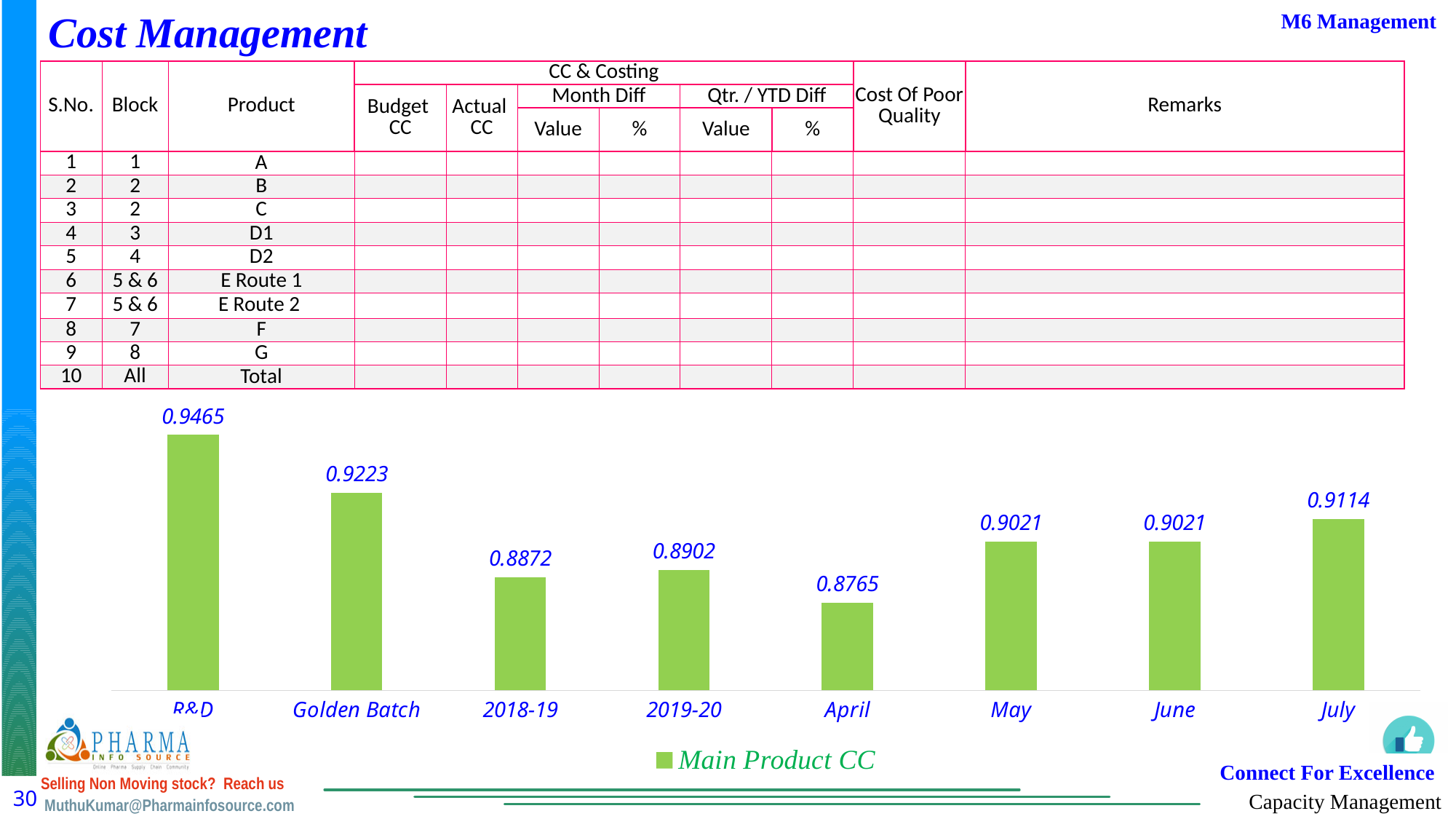
Which has a larger Main Product CC value, 2018-19 or 2019-20? 2019-20 What series name does the chart legend show? Main Product CC What is the difference between the Main Product CC values for R&D and Golden Batch? 0.0242 How many categories are shown on the bar chart? 8 What is the Main Product CC value for R&D? 0.9465 What is the Main Product CC value for July? 0.9114 What is the Main Product CC value for Golden Batch? 0.9223 What kind of chart is shown on the slide? Bar chart What is the difference between the Main Product CC values for July and June? 0.0093 Which category has the lowest Main Product CC value? April What is the Main Product CC value for April? 0.8765 Which category has the highest Main Product CC value? R&D